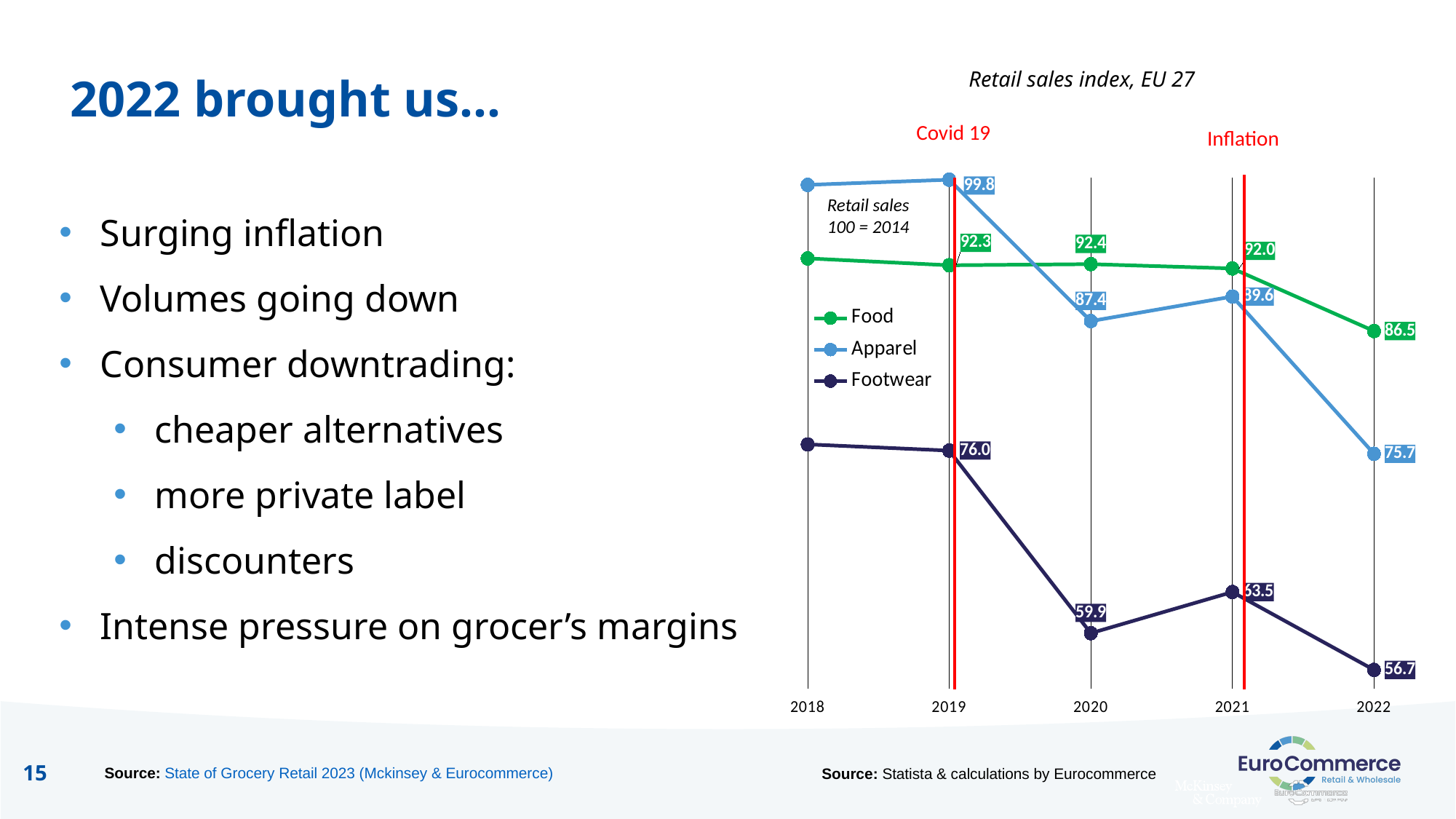
What is the Apparel retail sales index value in 2019? 99.8 What is the Footwear retail sales index value in 2020? 59.9 Which is larger in 2021, the Food value or the Apparel value? Food What is the Apparel retail sales index value in 2022? 75.7 Does the Footwear series rise or fall from 2019 to 2022 overall? Fall How many years are shown on the x axis of the chart? 5 Which series has the highest value in 2019? Apparel Which series has the lowest value in 2022? Footwear What is the difference between the Food and Apparel values in 2022? 10.8 How many series does the chart legend list? 3 What type of chart is shown on the slide? Line chart What is the Food retail sales index value in 2022? 86.5